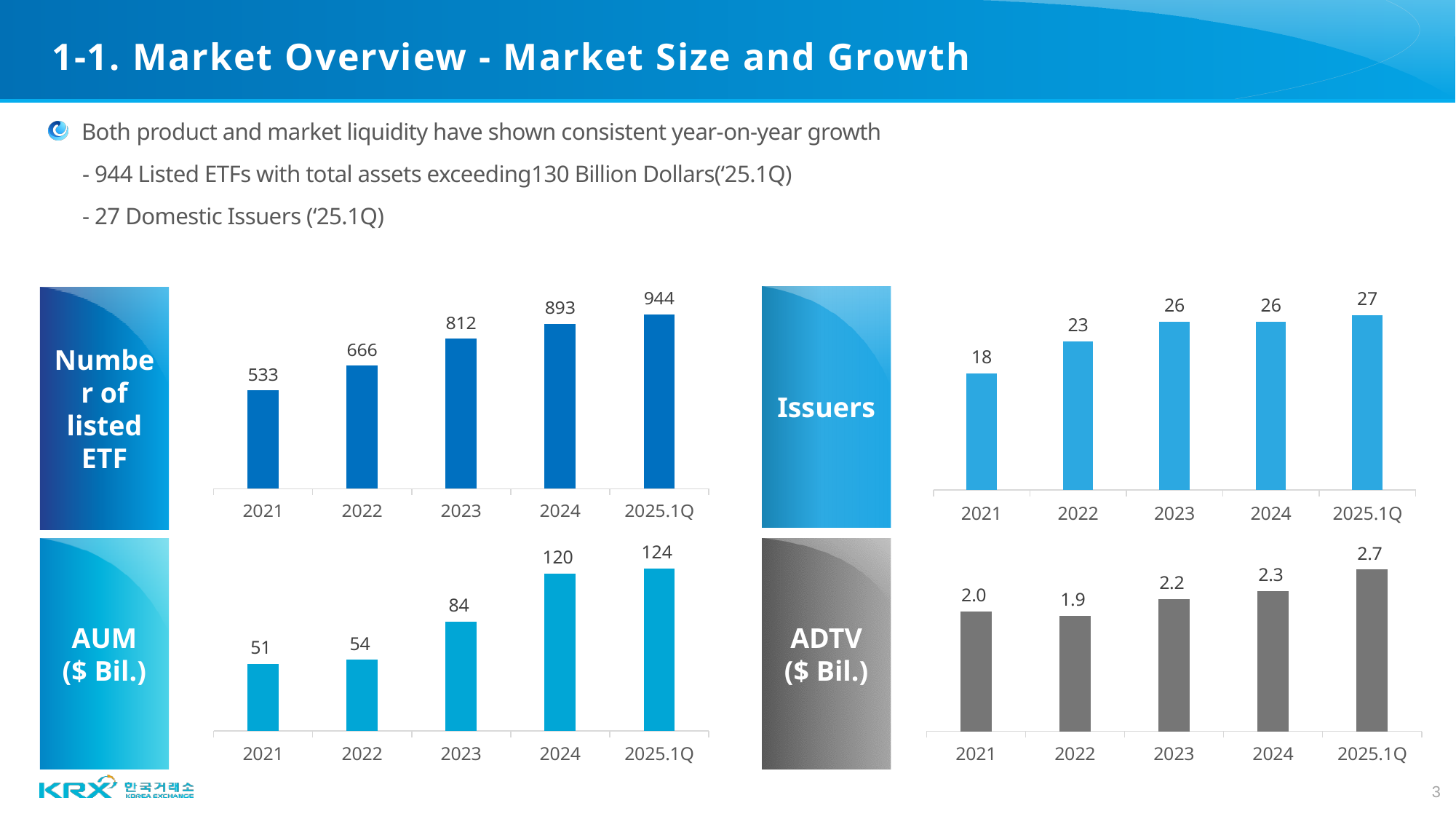
In the 'AUM ($ Bil.)' chart, which category has the highest value? 2025.1Q In the 'Number of listed ETF' chart, what is the value for 2023? 812 In the 'Number of listed ETF' chart, what is the difference between the 2025.1Q value and the 2021 value? 411 What kind of chart is the 'ADTV ($ Bil.)' chart? Bar chart How many categories are shown on the x axis of the 'Issuers' chart? 5 In the 'Issuers' chart, which year has the lowest value? 2021 In the 'AUM ($ Bil.)' chart, what is the value for 2024? 120 In the 'Issuers' chart, what is the value for 2022? 23 In the 'ADTV ($ Bil.)' chart, which is larger, the value for 2021 or the value for 2022? 2021 In the 'AUM ($ Bil.)' chart, what is the difference between the 2023 value and the 2022 value? 30 In the 'ADTV ($ Bil.)' chart, what is the value for 2025.1Q? 2.7 In the 'Number of listed ETF' chart, do the values rise or fall from 2021 to 2025.1Q? Rise